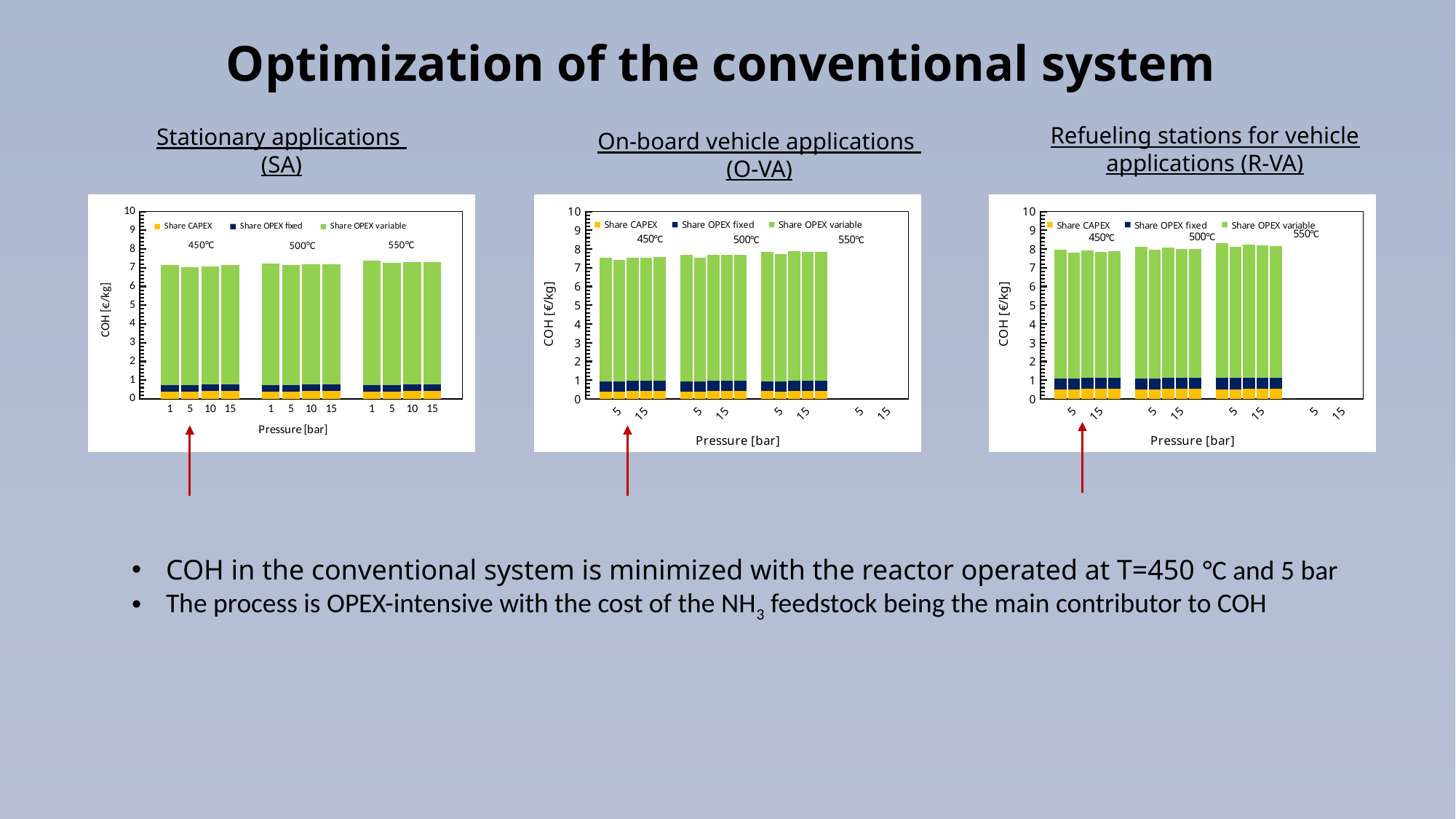
How many temperature groups are shown in the Refueling stations for vehicle applications (R-VA) chart? 3 In the Refueling stations for vehicle applications (R-VA) chart, is the total COH of the first bar at 550°C greater or less than 5? greater In the Stationary applications (SA) chart, is the total COH for the bar at 450°C and 5 bar greater or less than 5? greater What colour represents Share OPEX variable in the Stationary applications (SA) chart? green What is the y-axis label of the Refueling stations for vehicle applications (R-VA) chart? COH [€/kg] In the Stationary applications (SA) chart, is the total COH for the bar at 450°C and 5 bar greater or less than 8? less In the Stationary applications (SA) chart, which series makes up the largest part of each bar? Share OPEX variable How many series does the legend of the On-board vehicle applications (O-VA) chart list? 3 In the On-board vehicle applications (O-VA) chart, which is larger in each bar: the Share OPEX variable segment or the Share CAPEX segment? Share OPEX variable What kind of chart is the Stationary applications (SA) chart? stacked bar chart In the Stationary applications (SA) chart, how many bars are plotted in total? 12